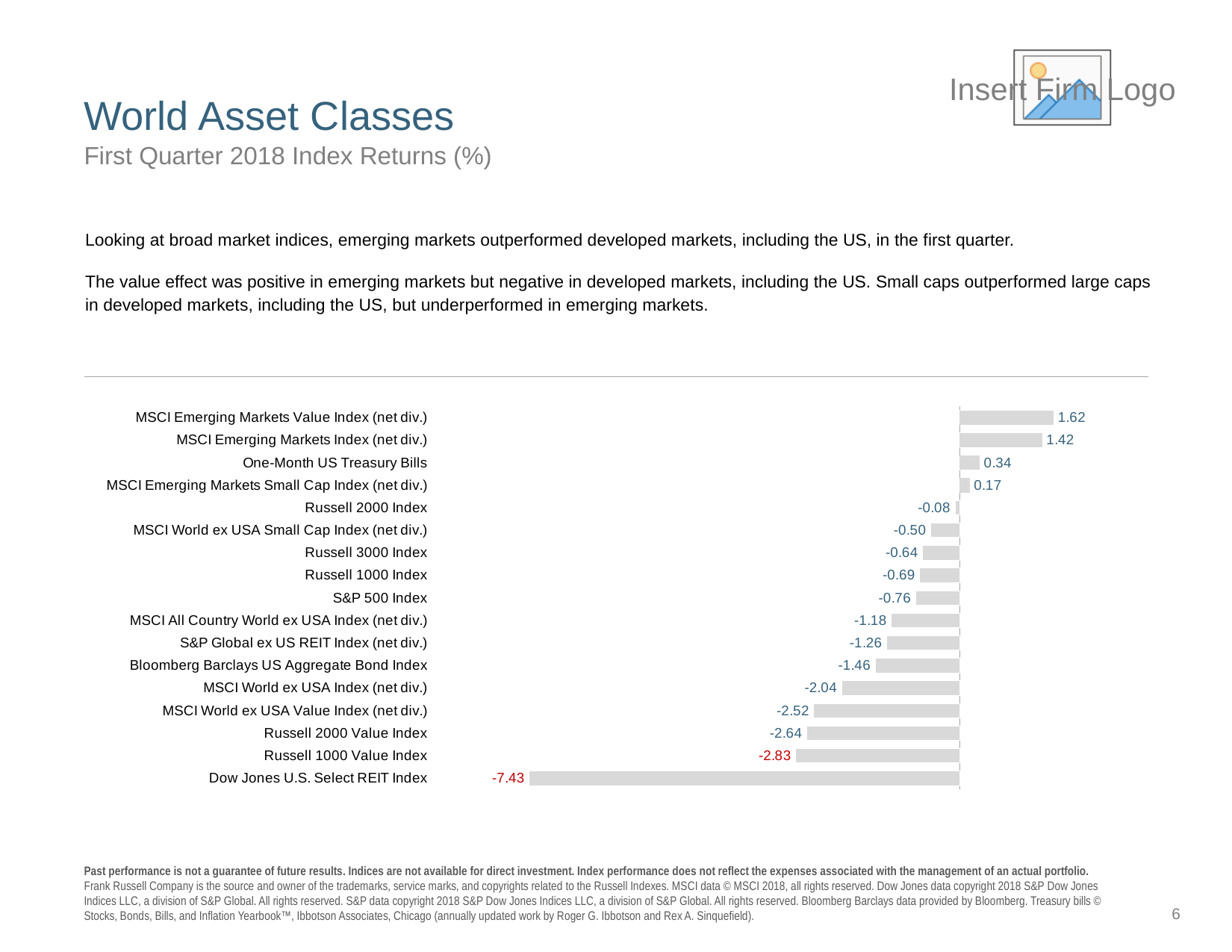
Which has the higher return, the Russell 1000 Index or the Russell 1000 Value Index? Russell 1000 Index What is the first quarter 2018 return for the MSCI Emerging Markets Index (net div.)? 1.42 What is the value shown for the Dow Jones U.S. Select REIT Index? -7.43 What is the value shown for the Bloomberg Barclays US Aggregate Bond Index? -1.46 What is the difference between the Russell 2000 Index and the Russell 2000 Value Index returns? 2.56 How many indices are plotted on the chart? 17 What is the value shown for the S&P 500 Index? -0.76 What kind of chart is shown on the slide? Bar chart What is the difference between the MSCI Emerging Markets Value Index (net div.) and the MSCI Emerging Markets Index (net div.) returns? 0.20 Which index has the lowest return on the chart? Dow Jones U.S. Select REIT Index Which has the higher return, One-Month US Treasury Bills or the MSCI Emerging Markets Small Cap Index (net div.)? One-Month US Treasury Bills Which index has the highest return on the chart? MSCI Emerging Markets Value Index (net div.)